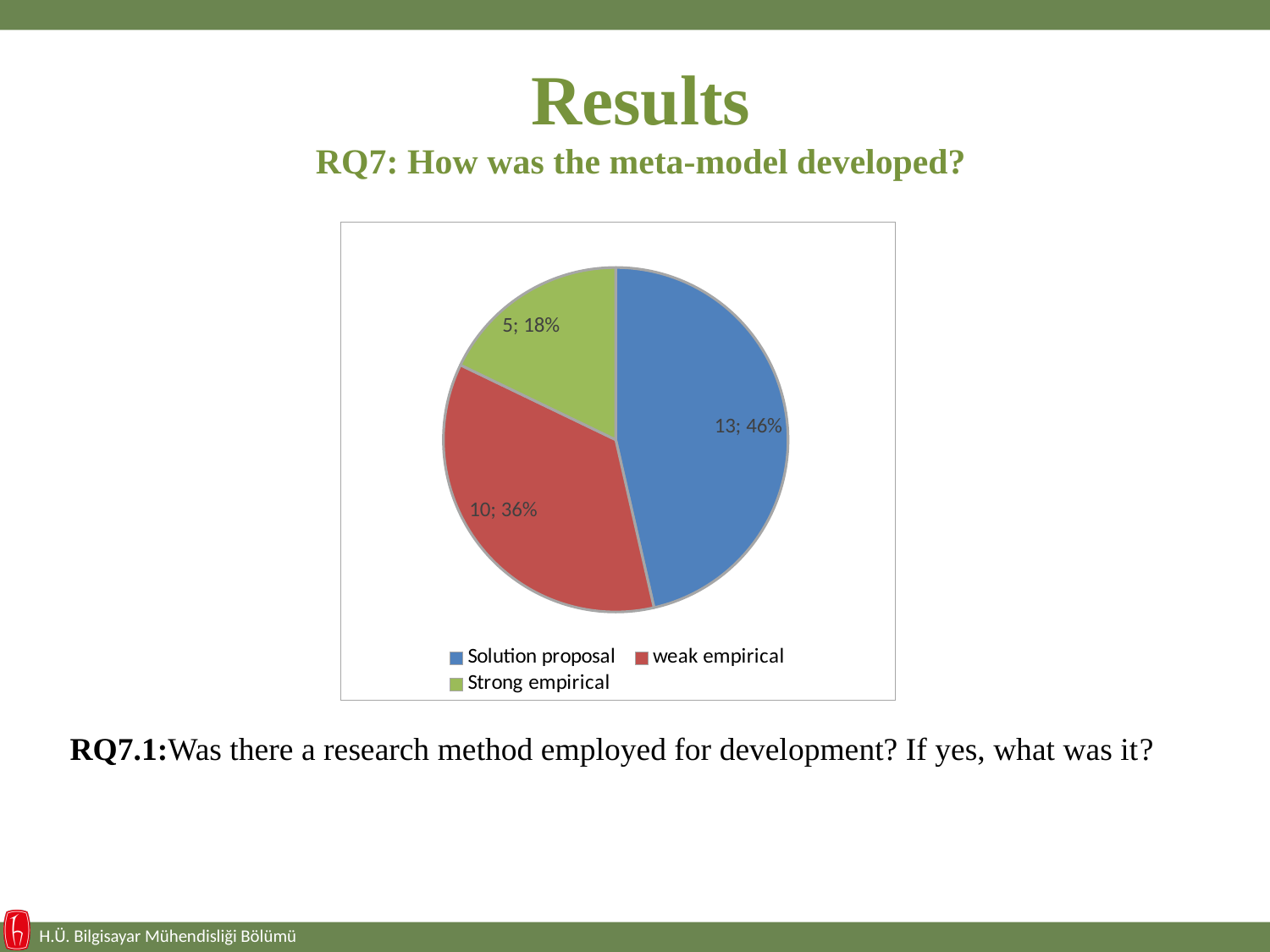
Which category has the largest slice? Solution proposal What kind of chart is shown on the slide? pie chart What share of the pie does Strong empirical take? 18% What is the count for weak empirical? 10 What is the difference between the counts for Solution proposal and weak empirical? 3 What is the count for Solution proposal? 13 What is the count for Strong empirical? 5 How many slices does the pie chart have? 3 Which category has the smallest slice? Strong empirical How many entries does the legend list? 3 What share of the pie does Solution proposal take? 46% Which colour represents weak empirical in the pie chart? red